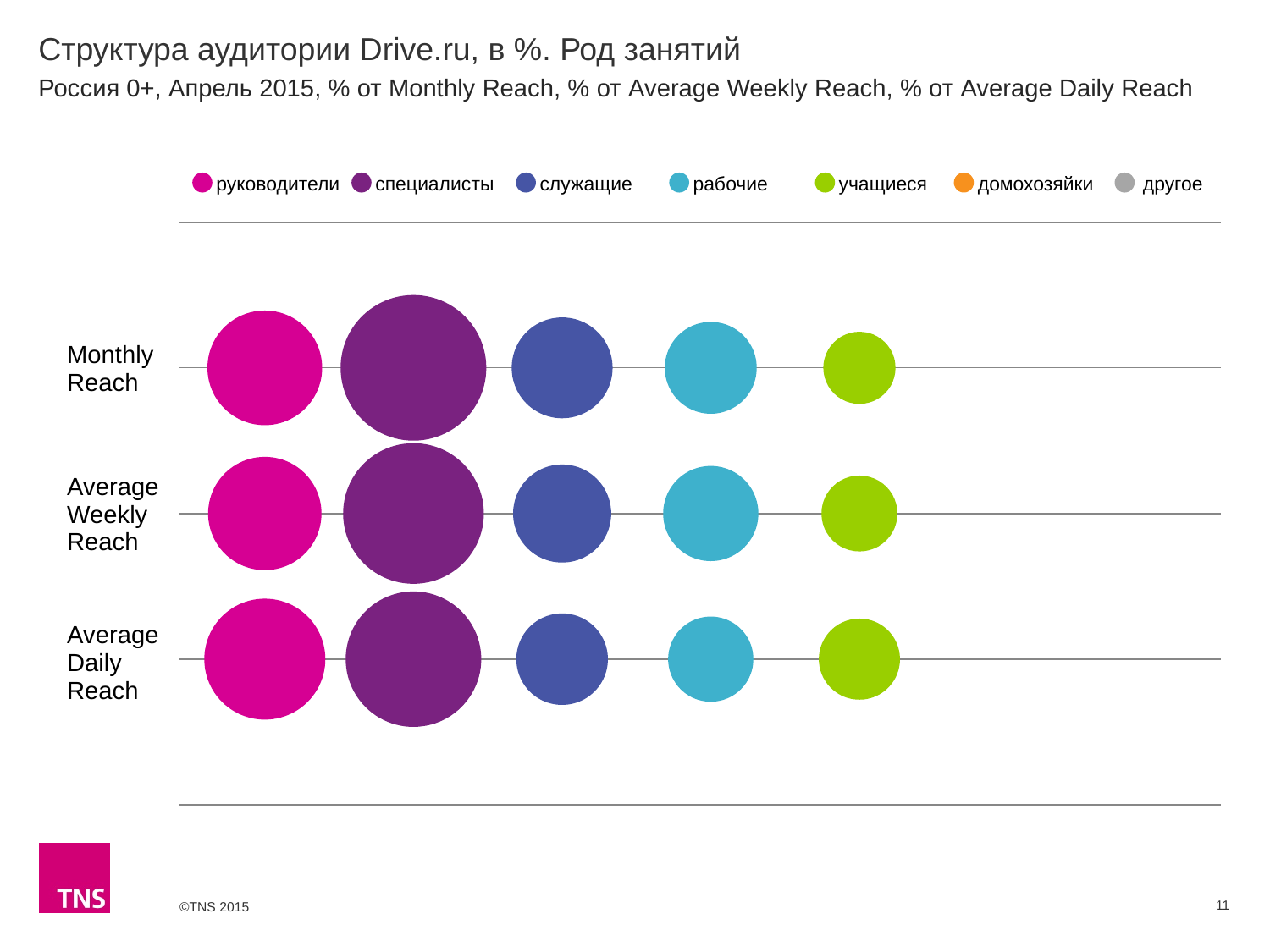
How many reach categories (rows) are plotted on the chart? 3 Which occupation group is shown in green in the legend? учащиеся What is the title of the chart on the slide? Структура аудитории Drive.ru, в %. Род занятий How many occupation groups does the legend list? 7 In the Average Daily Reach row, which bubble is larger: специалисты or рабочие? специалисты What kind of chart is shown on the slide? bubble chart Among the bubbles shown in the Monthly Reach row, which occupation group has the smallest bubble? учащиеся In the Monthly Reach row, which bubble is larger: руководители or учащиеся? руководители Which occupation group has the largest bubble in the Average Daily Reach row? специалисты How many bubbles are visible in each reach row? 5 In the Average Weekly Reach row, which bubble is larger: специалисты or служащие? специалисты Which occupation group has the largest bubble in the Monthly Reach row? специалисты